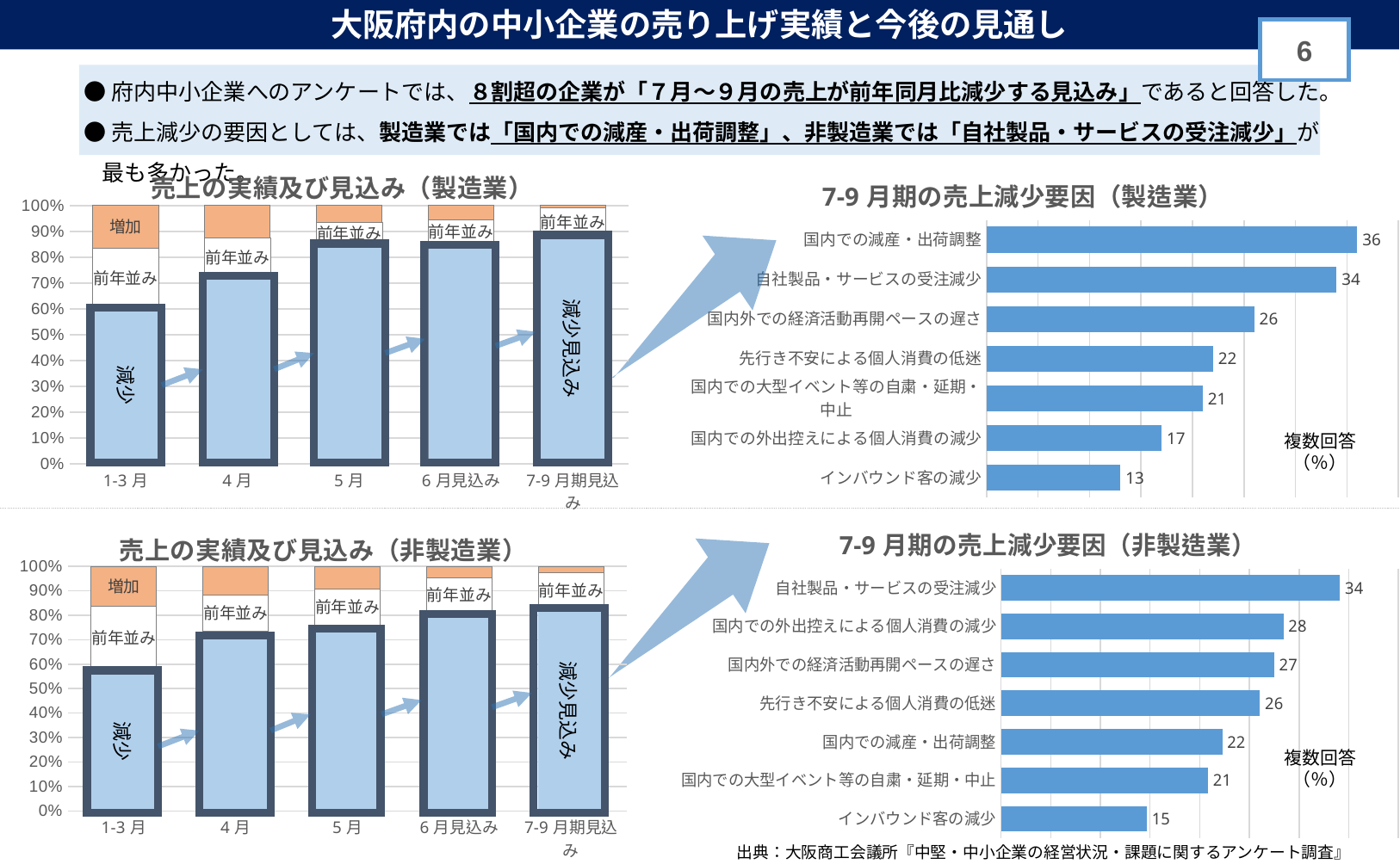
In the chart titled 7-9月期の売上減少要因（非製造業）, what is the value for 国内での外出控えによる個人消費の減少? 28 In the chart titled 7-9月期の売上減少要因（製造業）, what is the value for 国内での減産・出荷調整? 36 In the chart titled 7-9月期の売上減少要因（製造業）, what is the difference between 国内での減産・出荷調整 and 自社製品・サービスの受注減少? 2 In the chart titled 7-9月期の売上減少要因（非製造業）, which is larger: 先行き不安による個人消費の低迷 or 国内での減産・出荷調整? 先行き不安による個人消費の低迷 In the chart titled 売上の実績及び見込み（非製造業）, how many time periods are shown on the x axis? 5 In the chart titled 7-9月期の売上減少要因（製造業）, how many categories are shown? 7 In the chart titled 7-9月期の売上減少要因（製造業）, which category has the lowest value? インバウンド客の減少 In the chart titled 売上の実績及び見込み（製造業）, is the 減少見込み share for 7-9月期見込み greater or less than 80%? greater In the chart titled 7-9月期の売上減少要因（非製造業）, which category has the highest value? 自社製品・サービスの受注減少 In the chart titled 売上の実績及び見込み（非製造業）, does the 減少 share rise or fall from 1-3月 to 7-9月期見込み? rise What kind of chart is 7-9月期の売上減少要因（非製造業）? bar chart In the chart titled 7-9月期の売上減少要因（非製造業）, what is the difference between 自社製品・サービスの受注減少 and インバウンド客の減少? 19